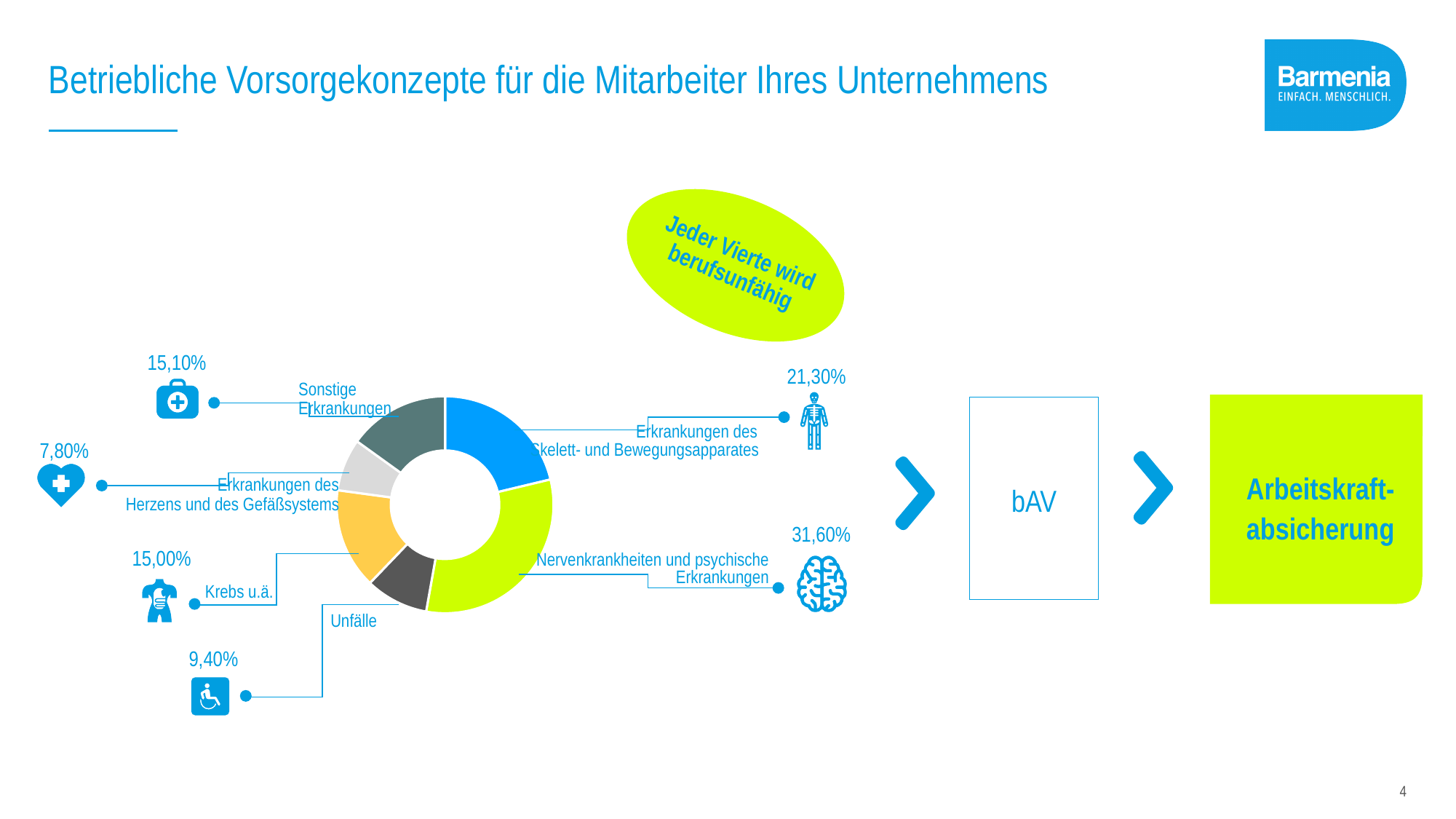
What kind of chart is shown on the slide? Donut (pie) chart What value is shown for Erkrankungen des Skelett- und Bewegungsapparates? 21,30% What value is shown for Sonstige Erkrankungen? 15,10% How many categories does the donut chart show? 6 Which category has the smallest share in the donut chart? Erkrankungen des Herzens und des Gefäßsystems What value is shown for Unfälle? 9,40% What is the difference between the shares for Nervenkrankheiten und psychische Erkrankungen and Erkrankungen des Skelett- und Bewegungsapparates? 10,30% Which is larger: the share for Unfälle or the share for Krebs u.ä.? Krebs u.ä. What share of the donut chart is attributed to Nervenkrankheiten und psychische Erkrankungen? 31,60% Which category has the largest share in the donut chart? Nervenkrankheiten und psychische Erkrankungen What value is shown for Krebs u.ä.? 15,00% What value is shown for Erkrankungen des Herzens und des Gefäßsystems? 7,80%